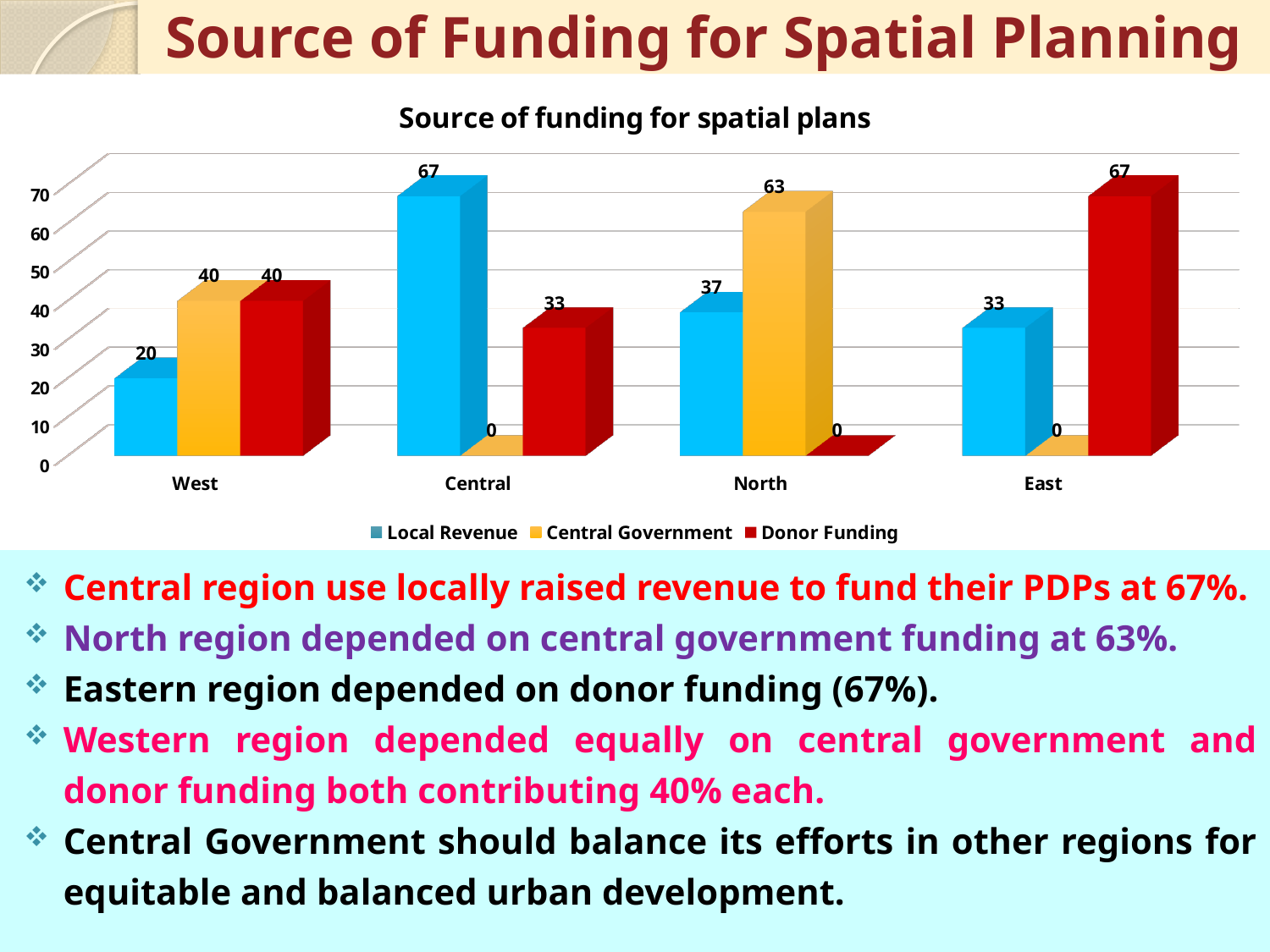
What is the title of the chart? Source of funding for spatial plans Which region has the highest Local Revenue value? Central What is the Donor Funding value for East? 67 How many regions are shown on the x axis? 4 What is the Central Government value for North? 63 Which region has the lowest Local Revenue value? West What is the difference between the Donor Funding values for East and West? 27 What kind of chart is shown on the slide? Bar chart Which is larger: the Central Government value for North or the Central Government value for West? North How many series does the legend list? 3 What is the Local Revenue value for Central? 67 What is the Local Revenue value for West? 20